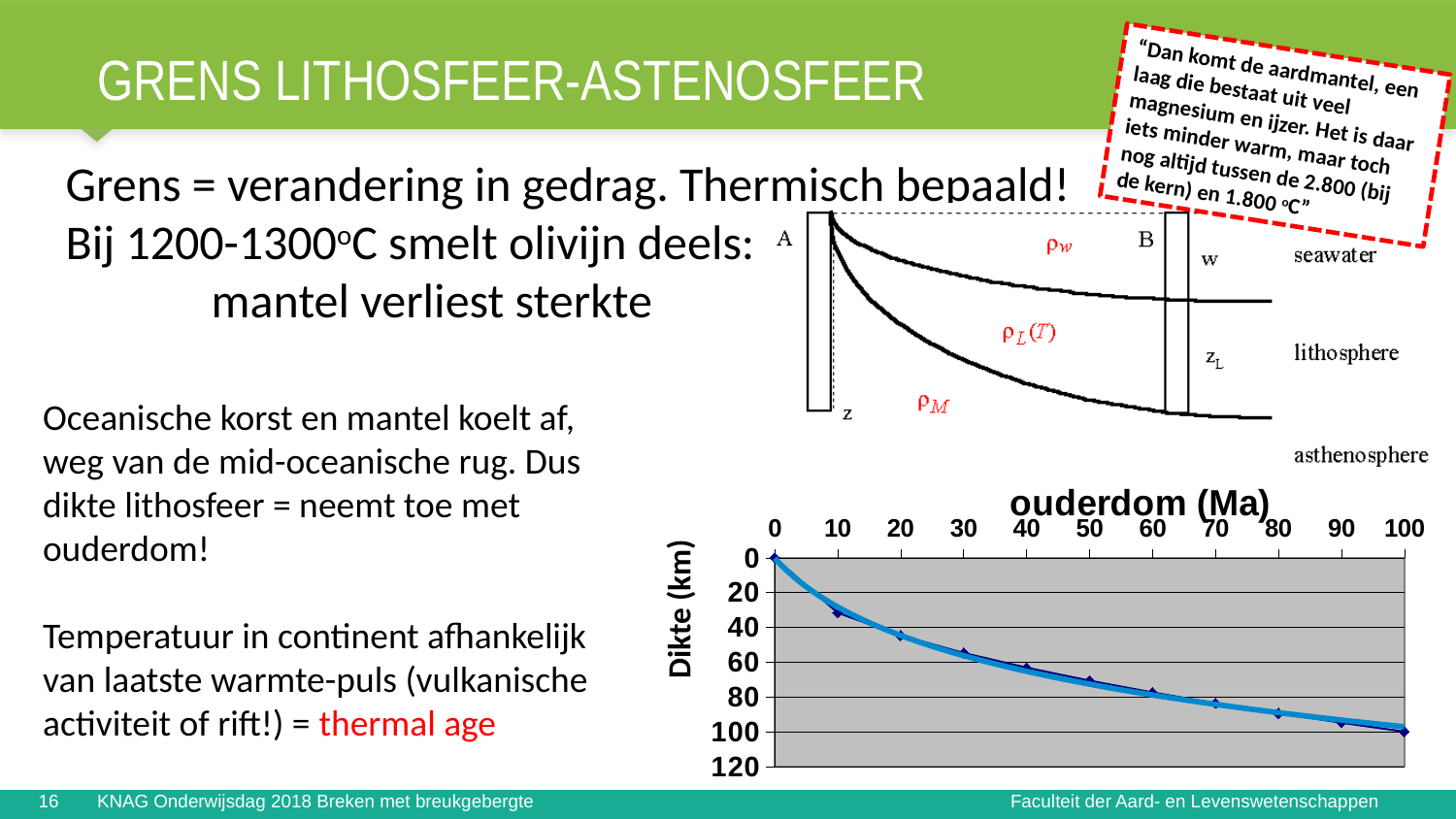
At which ouderdom (Ma) is the Dikte (km) value highest? 100 Is the Dikte (km) value at ouderdom 50 Ma greater or less than 60? greater At which ouderdom (Ma) is the Dikte (km) value lowest? 0 What is the Dikte (km) value at ouderdom 0 Ma? 0 What is the title of the y axis of the chart? Dikte (km) Is the Dikte (km) value at ouderdom 10 Ma greater or less than 20? greater Is the Dikte (km) value at ouderdom 20 Ma greater or less than 60? less Does the Dikte (km) value increase or decrease as ouderdom (Ma) increases? increase What is the title of the x axis of the chart? ouderdom (Ma) How many data points are plotted on the chart? 11 What kind of chart is shown at the bottom right of the slide? line chart Which has the larger Dikte (km) value: ouderdom 40 Ma or ouderdom 80 Ma? 80 Ma